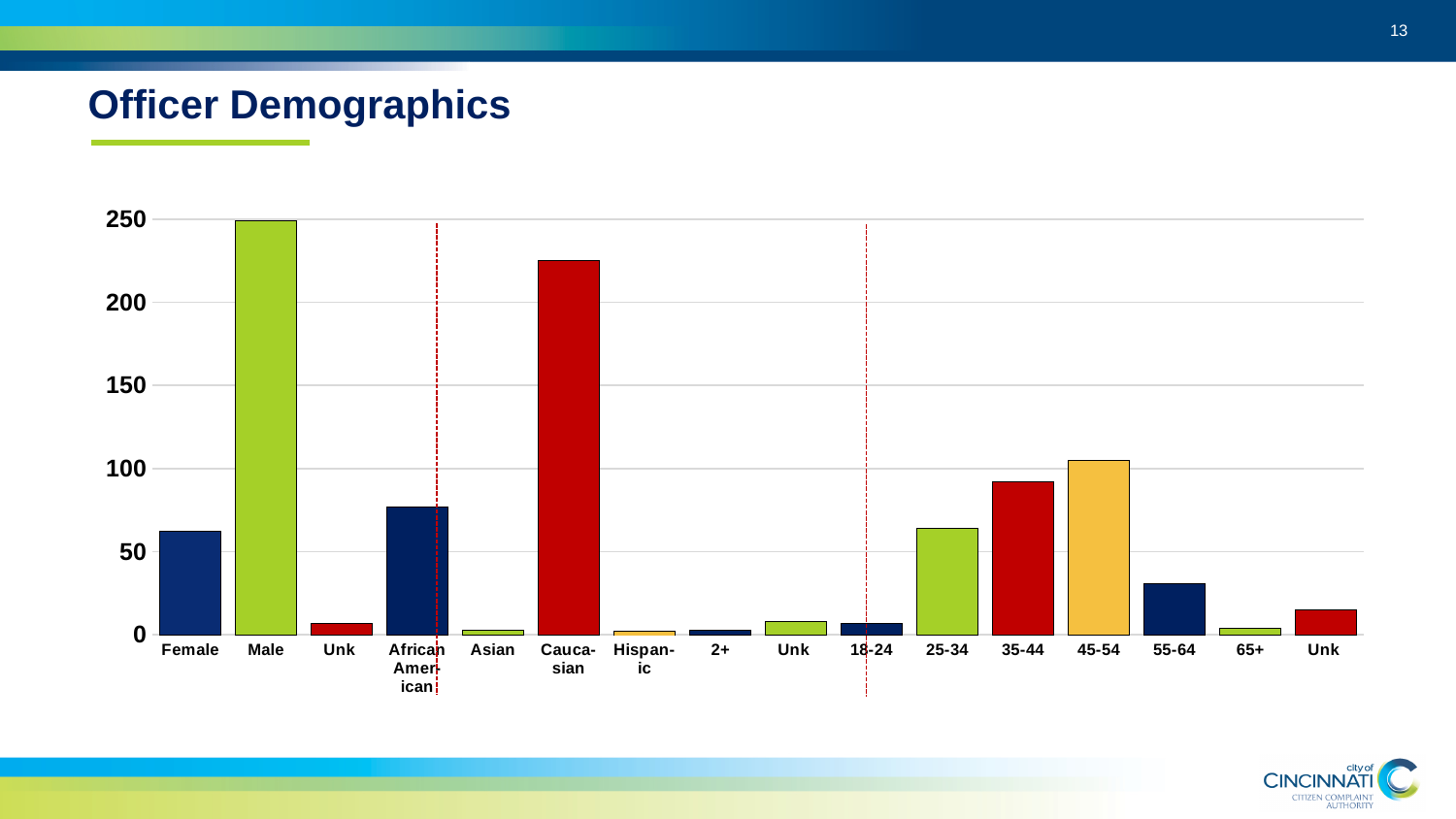
Is the value for Female greater or less than 50? greater Which category has the highest value in the chart? Male Which is larger, the value for Male or the value for Caucasian? Male Is the value for Caucasian greater or less than 200? greater Is the value for 55-64 greater or less than 50? less What is the title of the chart on the slide? Officer Demographics How many categories are shown along the x axis of the chart? 16 What kind of chart is shown on the slide? bar chart Which is larger, the value for 45-54 or the value for 35-44? 45-54